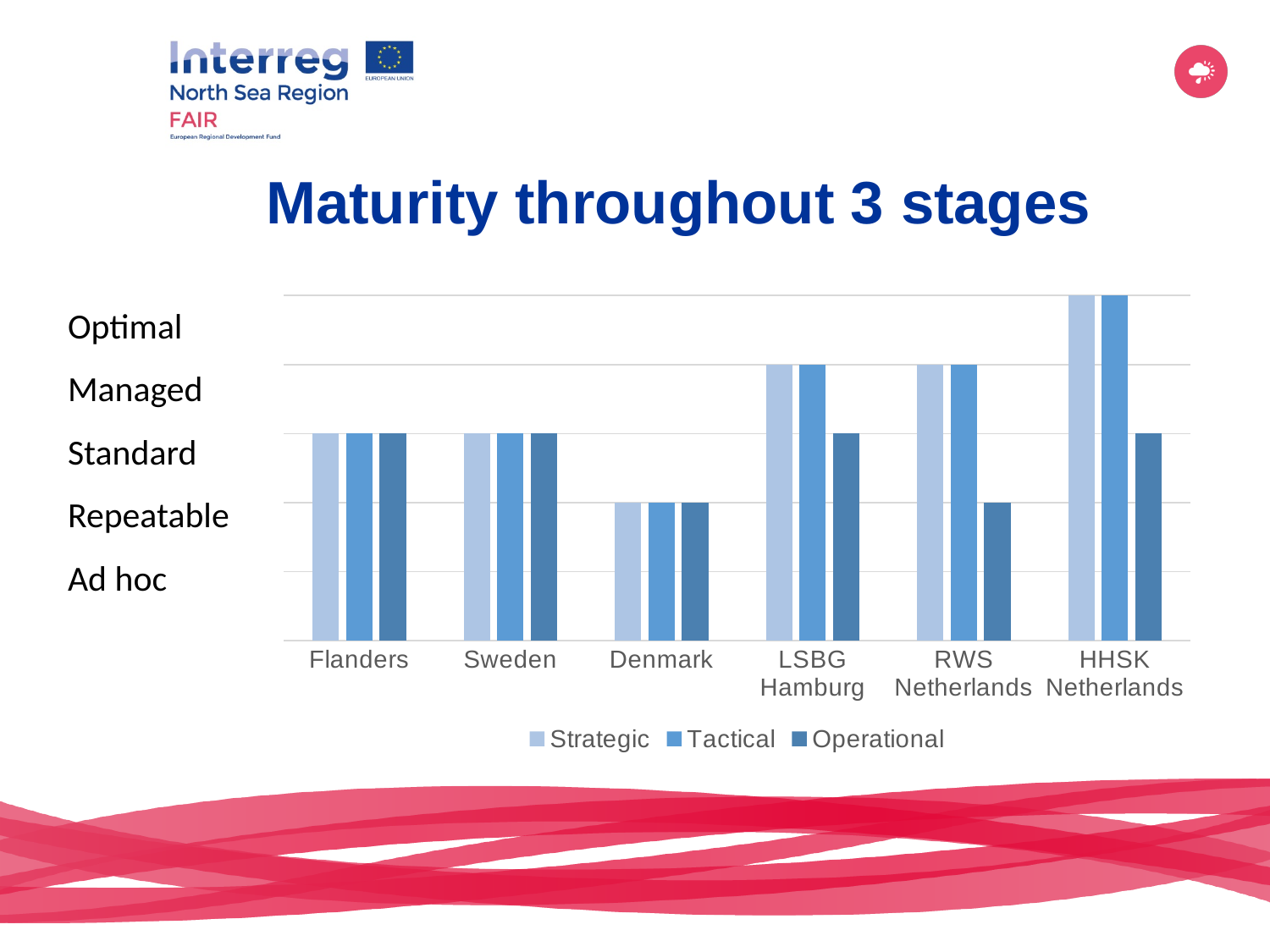
What are the three series named in the legend? Strategic, Tactical, Operational Which category has the lowest Tactical bar? Denmark Which is higher, the Strategic bar for LSBG Hamburg or the Strategic bar for Flanders? LSBG Hamburg Which category has the highest Strategic bar? HHSK Netherlands Which is higher, the Operational bar for Flanders or the Operational bar for RWS Netherlands? Flanders How many series does the legend list? 3 What maturity level does the Tactical bar for Denmark reach? Repeatable What is the title of the chart? Maturity throughout 3 stages What type of chart is shown on the slide? bar chart How many categories are shown along the x axis? 6 Which is higher, the Tactical bar for HHSK Netherlands or the Tactical bar for RWS Netherlands? HHSK Netherlands What maturity level does the Strategic bar for HHSK Netherlands reach? Optimal